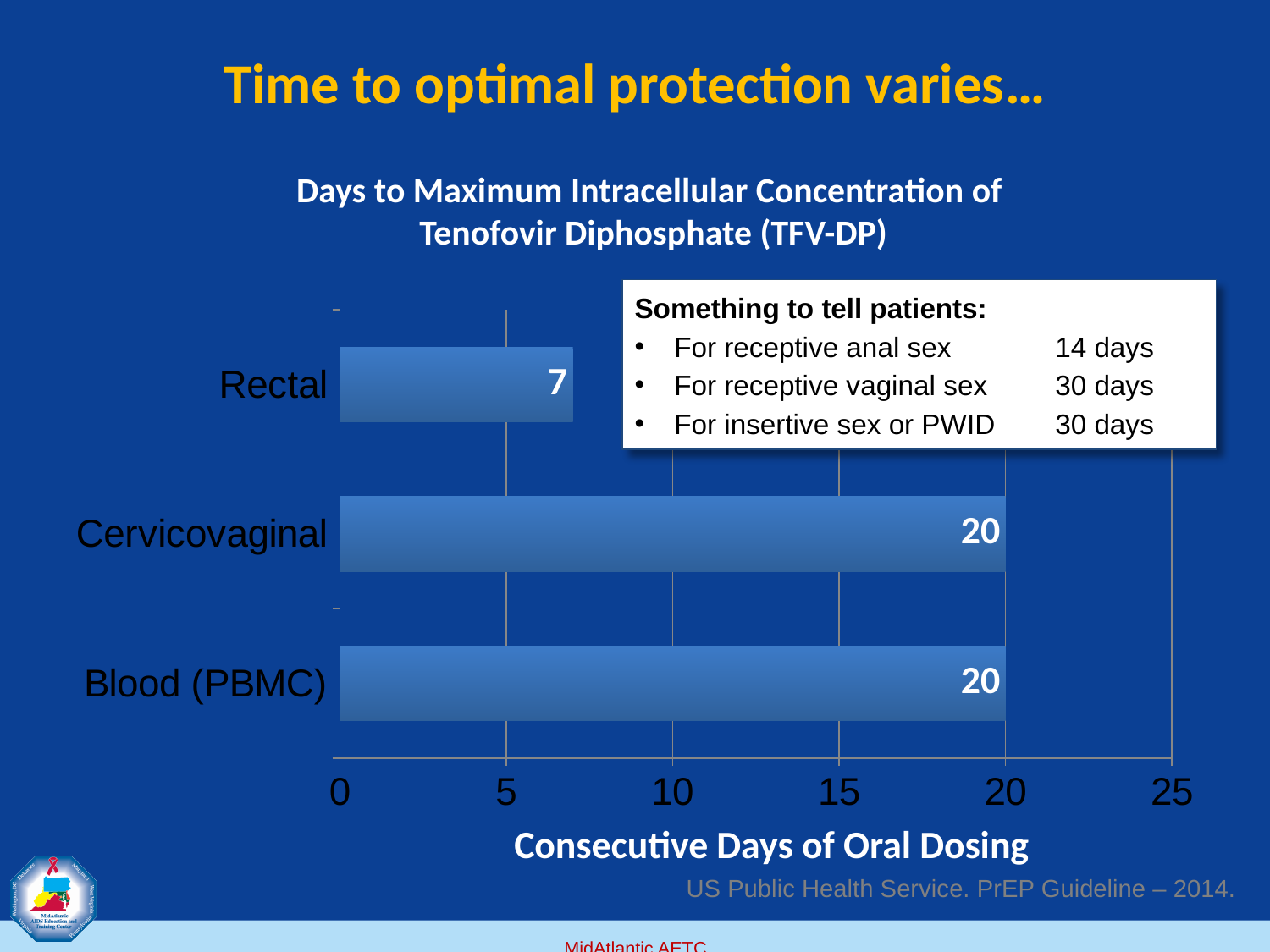
What kind of chart is shown on the slide? bar chart Which is larger, the value for Rectal or the value for Blood (PBMC)? Blood (PBMC) What is the value for Cervicovaginal? 20 What is the value for Rectal? 7 What is the label of the horizontal axis? Consecutive Days of Oral Dosing Which category has the lowest value? Rectal What is the value for Blood (PBMC)? 20 What is the difference between the values for Cervicovaginal and Rectal? 13 Is the value for Rectal greater or less than 10? less What is the title of the chart? Days to Maximum Intracellular Concentration of Tenofovir Diphosphate (TFV-DP) How many categories are shown in the chart? 3 Is the value for Cervicovaginal greater or less than 15? greater